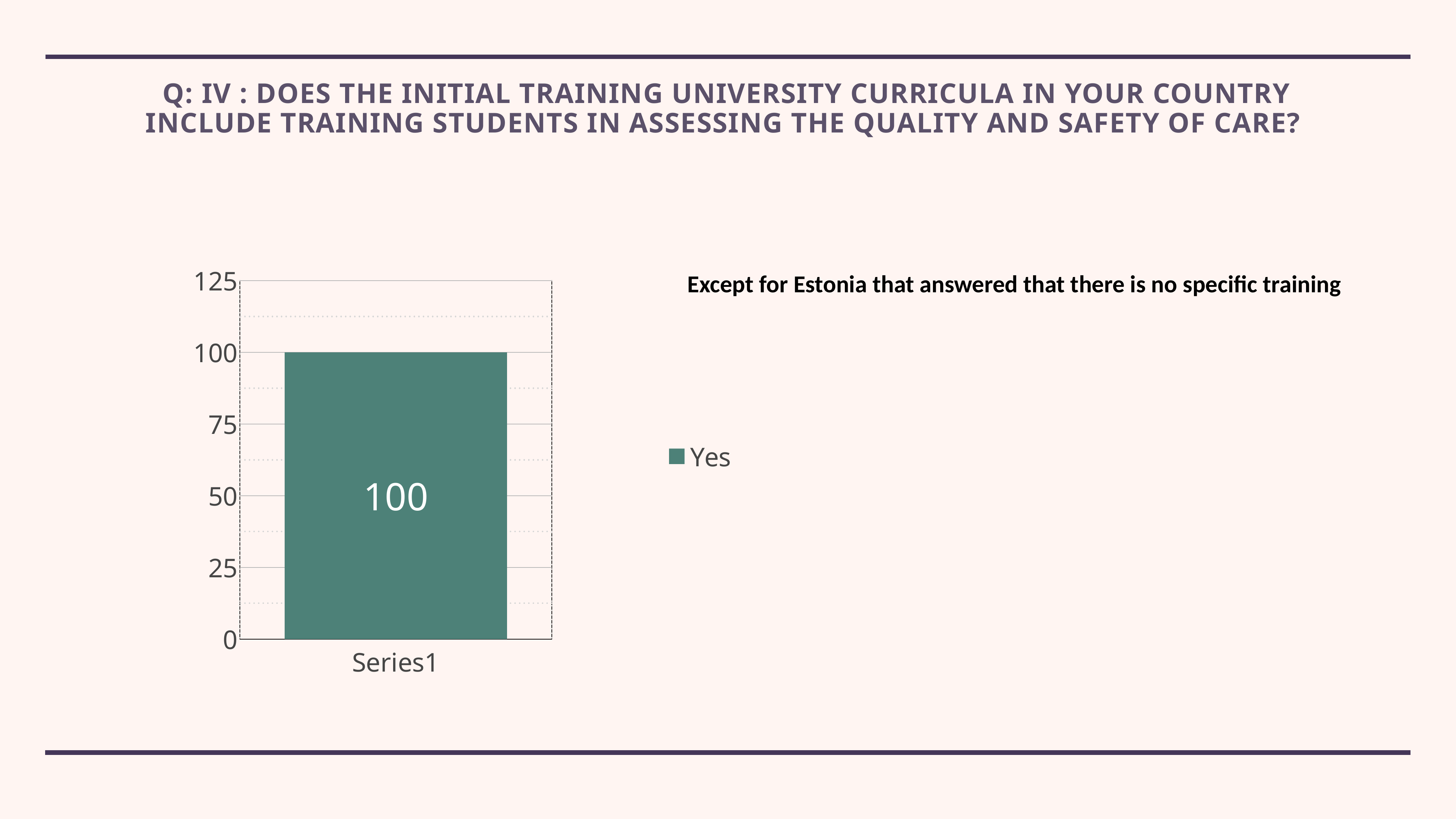
What is the value of the bar labelled Series1? 100 Is the value for Series1 greater or less than 125? less How many series does the legend list? 1 What is the legend entry for the series shown in the chart? Yes What kind of chart is shown on the slide? bar chart Is the value for Series1 greater or less than 75? greater What is the highest value shown on the vertical axis? 125 What is the category label shown on the x axis? Series1 How many bars are plotted in the chart? 1